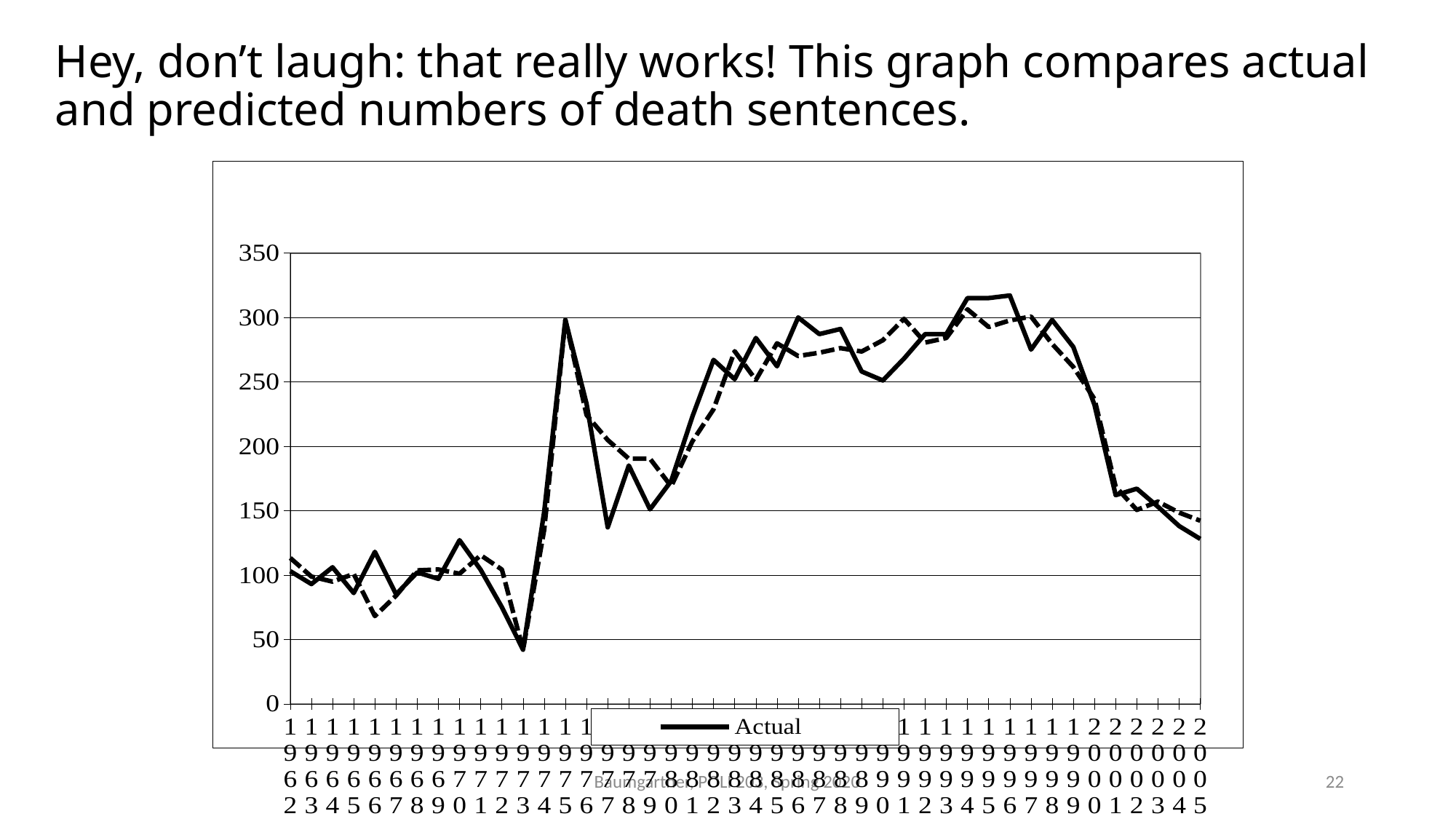
What is the highest value labelled on the y axis? 350 What is the first year shown on the x axis? 1962 Does the Actual series rise or fall from 2000 to 2005? fall Is the Actual value for 2005 greater or less than 150? less Which year has the lowest value for the Actual series? 1973 Is the Actual value for 1973 greater or less than 50? less Which is larger, the Actual value for 1975 or for 1977? 1975 What kind of chart is shown on the slide? line chart Is the Actual value for 1994 greater or less than 300? greater Does the Actual series rise or fall from 1973 to 1975? rise